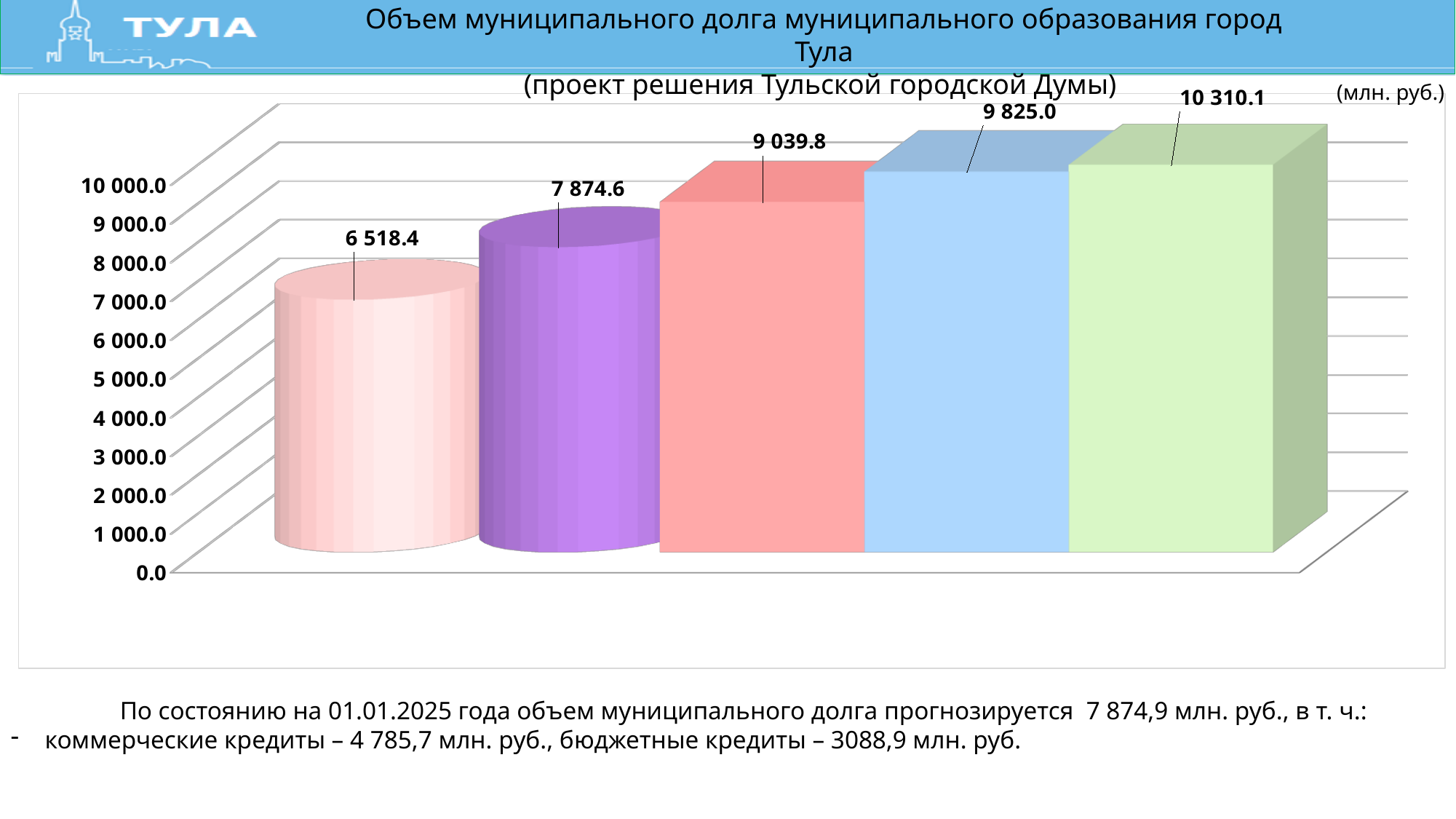
What type of chart is shown on the slide? bar chart What is the value shown on the fifth (rightmost, green) bar? 10 310.1 How many bars are plotted in the chart? 5 What is the value shown on the third (red) bar? 9 039.8 What is the value shown on the fourth (light blue) bar? 9 825.0 What is the difference between the values of the second (purple) bar and the first (light pink) bar? 1 356.2 What is the value shown on the second (purple) bar? 7 874.6 Which bar has the highest value? the fifth (rightmost, green) bar, 10 310.1 Which bar has the lowest value? the first (leftmost, light pink) bar, 6 518.4 Do the values rise or fall from left to right across the bars? rise What is the value shown on the first (leftmost, light pink) bar? 6 518.4 What unit of measurement is indicated for the chart values? млн. руб.